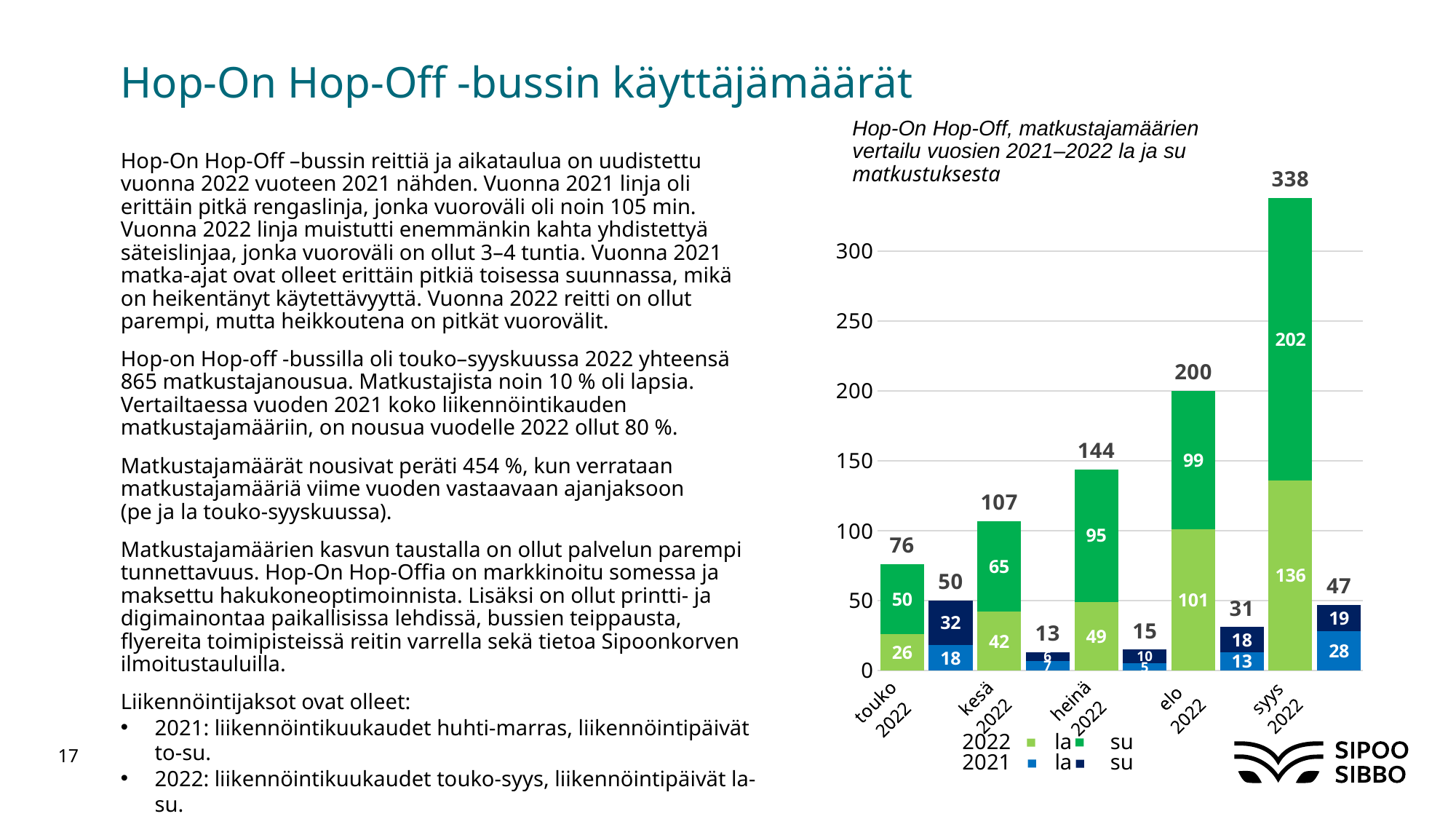
Which month has the lowest 2022 total? touko 2022 What is the total value of the 2022 bar for syys 2022? 338 What is the difference between the 2022 totals for syys 2022 and elo 2022? 138 What is the 2022 'su' value for heinä 2022? 95 How many months are shown on the x axis? 5 What kind of chart is shown on the slide? stacked bar chart What is the 2021 'su' value in the bar next to touko 2022? 32 What is the 2022 'la' value for elo 2022? 101 Do the 2022 totals rise or fall from touko 2022 to syys 2022? rise How many series does the legend list? 4 Which month has the highest 2022 total? syys 2022 Which is larger: the 2022 total for kesä 2022 or the 2022 total for heinä 2022? heinä 2022